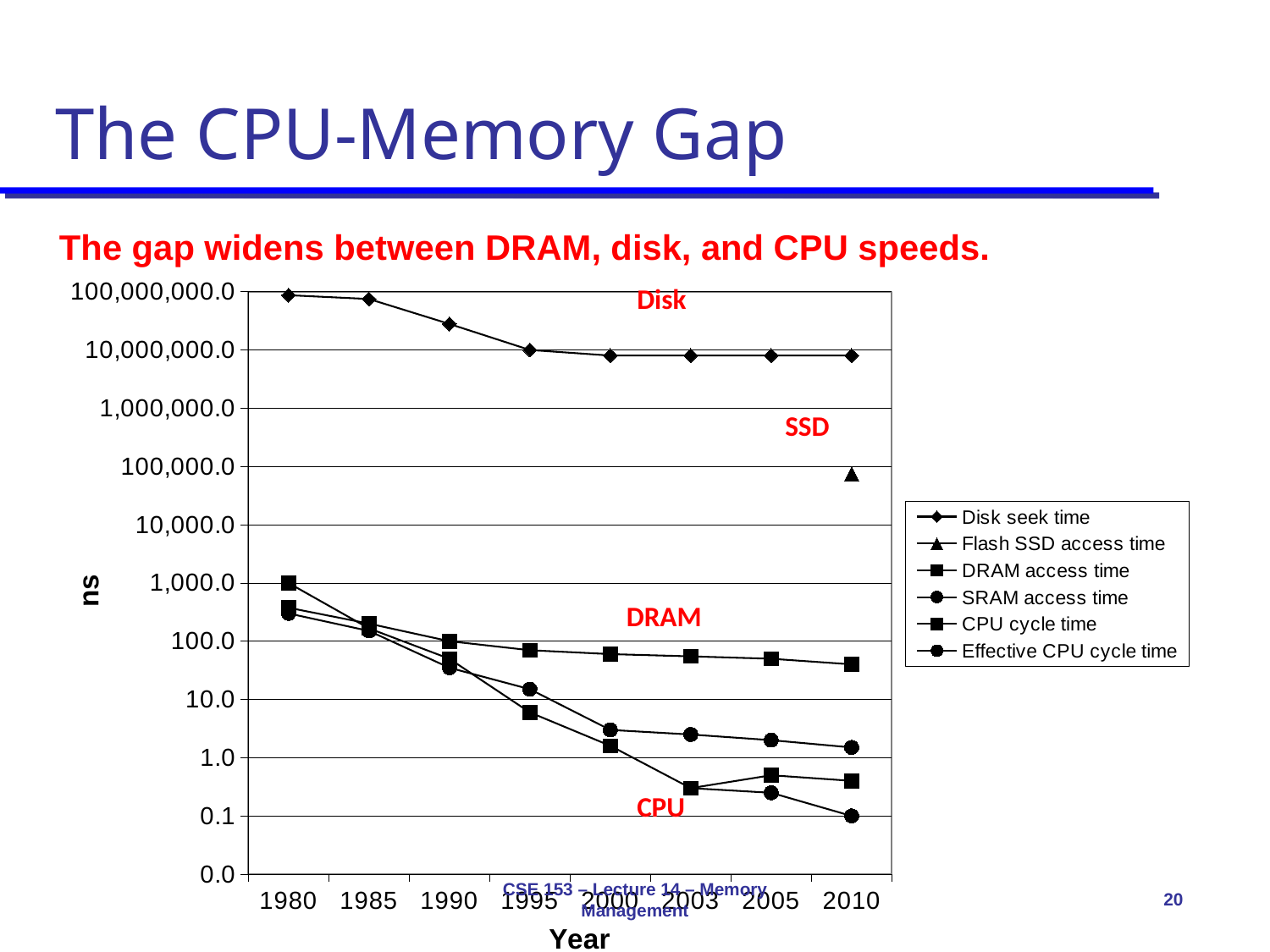
Is the Disk seek time value for 1990 greater or less than 10,000,000.0? greater How many years are marked along the x axis? 8 Is the Flash SSD access time value for 2010 greater or less than 10,000.0? greater Does the Disk seek time rise or fall from 1980 to 2010? fall What kind of chart is shown on the slide? line chart In 2010, which is larger: Disk seek time or DRAM access time? Disk seek time Which series has the highest values across all years? Disk seek time What is the label on the x axis? Year How many series does the legend list? 6 Is the Disk seek time value for 1980 greater or less than 10,000,000.0? greater What is the label on the y axis? ns